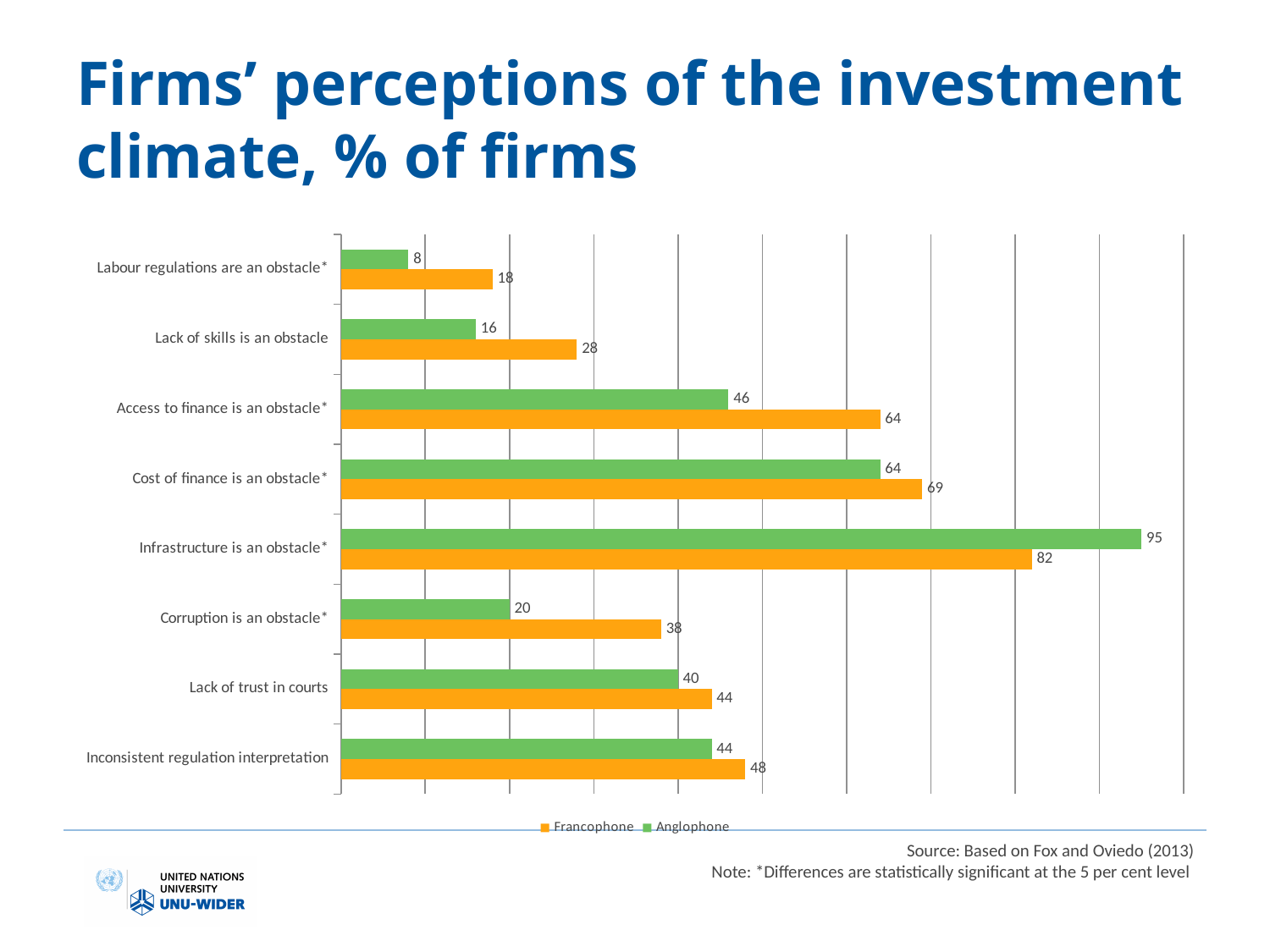
What is the Francophone value for 'Lack of skills is an obstacle'? 28 For 'Infrastructure is an obstacle*', which series has the larger value, Francophone or Anglophone? Anglophone For 'Access to finance is an obstacle*', which series has the larger value, Francophone or Anglophone? Francophone How many categories are shown on the chart? 8 How many series does the legend list? 2 What is the Francophone value for 'Infrastructure is an obstacle*'? 82 What kind of chart is shown on the slide? Bar chart What is the difference between the Francophone and Anglophone values for 'Corruption is an obstacle*'? 18 What colour are the Anglophone bars? Green Which category has the lowest Francophone value? Labour regulations are an obstacle* What is the Anglophone value for 'Corruption is an obstacle*'? 20 Which category has the highest Anglophone value? Infrastructure is an obstacle*